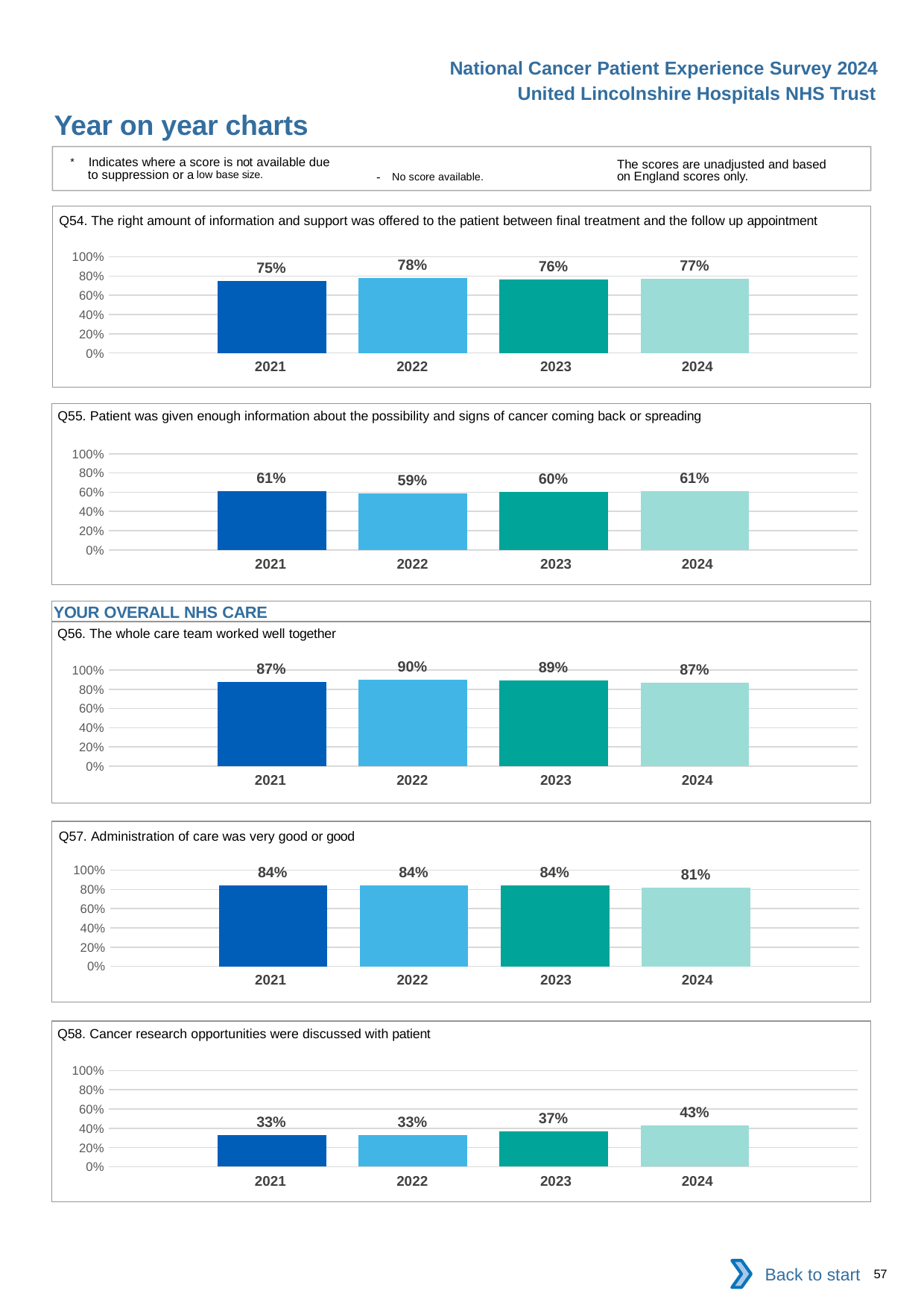
In the Q56 chart, which year has the highest value? 2022 What is the section heading shown above the Q56 chart? YOUR OVERALL NHS CARE What kind of chart is the Q56 chart? bar chart In the Q54 chart, what is the value for 2022? 78% In the Q58 chart, which is larger, the value for 2023 or the value for 2024? 2024 In the Q58 chart, is the value for 2021 greater or less than 40%? less In the Q58 chart, do the values rise or fall from 2022 to 2024? rise In the Q55 chart, which year has the lowest value? 2022 In the Q58 chart, what is the value for 2024? 43% In the Q57 chart, what is the difference between the 2023 value and the 2024 value? 3% How many years are shown in the Q54 chart? 4 In the Q55 chart, what is the difference between the 2021 value and the 2022 value? 2%